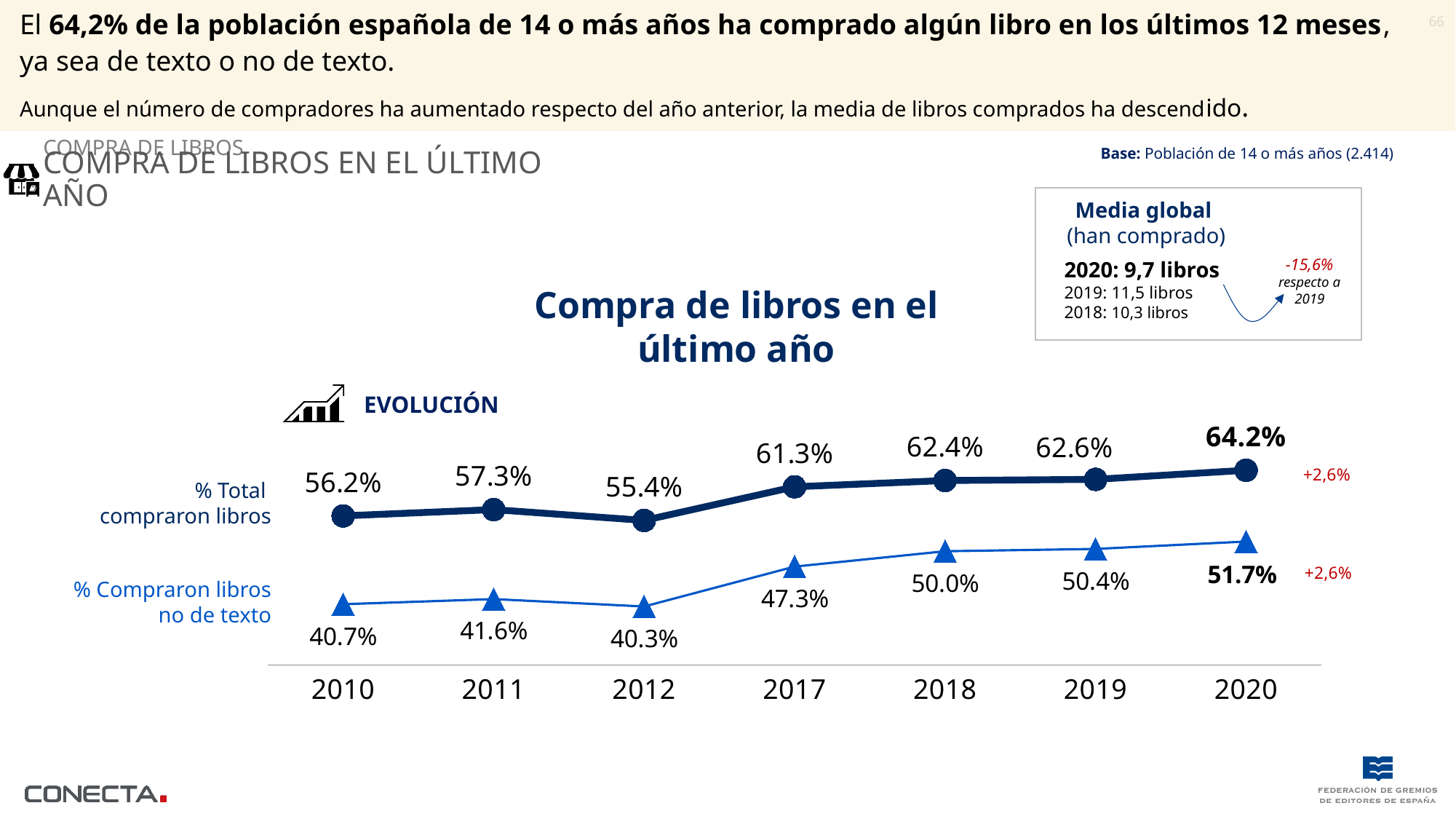
How many years are shown on the x axis? 7 How many series are plotted in the chart? 2 Does '% Compraron libros no de texto' rise or fall from 2017 to 2020? Rise What is the value for '% Total compraron libros' in 2020? 64.2% What is the title of the chart? Compra de libros en el último año What is the difference between '% Total compraron libros' and '% Compraron libros no de texto' in 2020? 12.5% In which year is '% Total compraron libros' highest? 2020 What is the value for '% Total compraron libros' in 2012? 55.4% In which year is '% Compraron libros no de texto' lowest? 2012 What is the value for '% Compraron libros no de texto' in 2017? 47.3% Which is larger: '% Total compraron libros' in 2011 or in 2012? 2011 What kind of chart is shown? Line chart